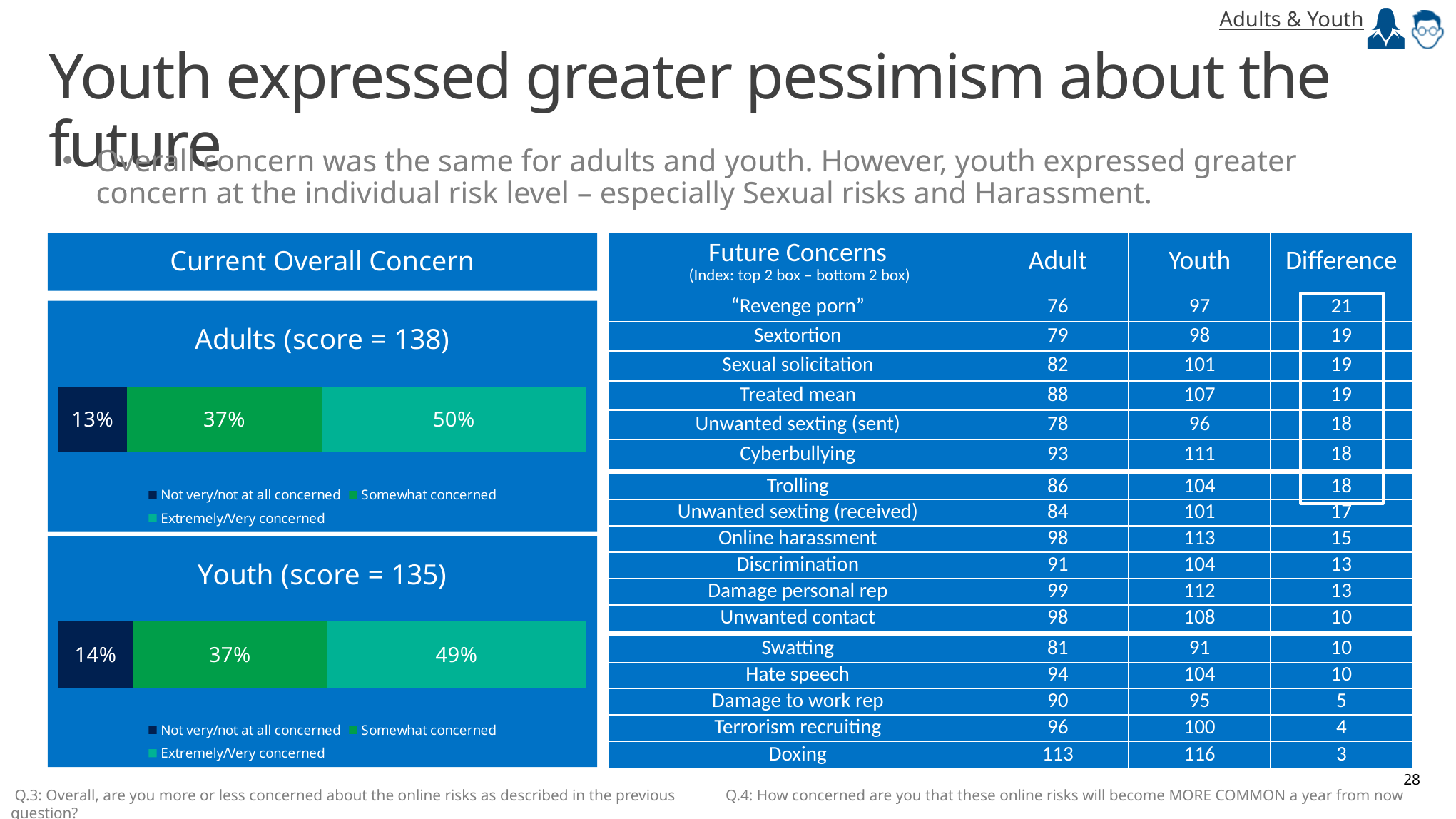
In the Youth (score = 135) chart, what percentage is shown for Somewhat concerned? 37% What is the title above the two stacked bar charts on the left of the slide? Current Overall Concern Which is larger: the Extremely/Very concerned share in the Adults chart or in the Youth chart? Adults In the Youth (score = 135) chart, which category has the smallest share? Not very/not at all concerned In the Adults (score = 138) chart, what percentage is shown for Extremely/Very concerned? 50% What kind of chart is used for the Youth (score = 135) data? Stacked bar chart In the Adults (score = 138) chart, which colour represents Not very/not at all concerned? Dark navy blue What is the total of the three segments in the Youth (score = 135) stacked bar? 100% How many series does the legend of the Adults (score = 138) chart list? 3 In the Youth (score = 135) chart, what percentage is shown for Not very/not at all concerned? 14% In the Adults (score = 138) chart, which category has the largest share? Extremely/Very concerned In the Adults (score = 138) chart, what is the difference between the Extremely/Very concerned and Somewhat concerned percentages? 13%